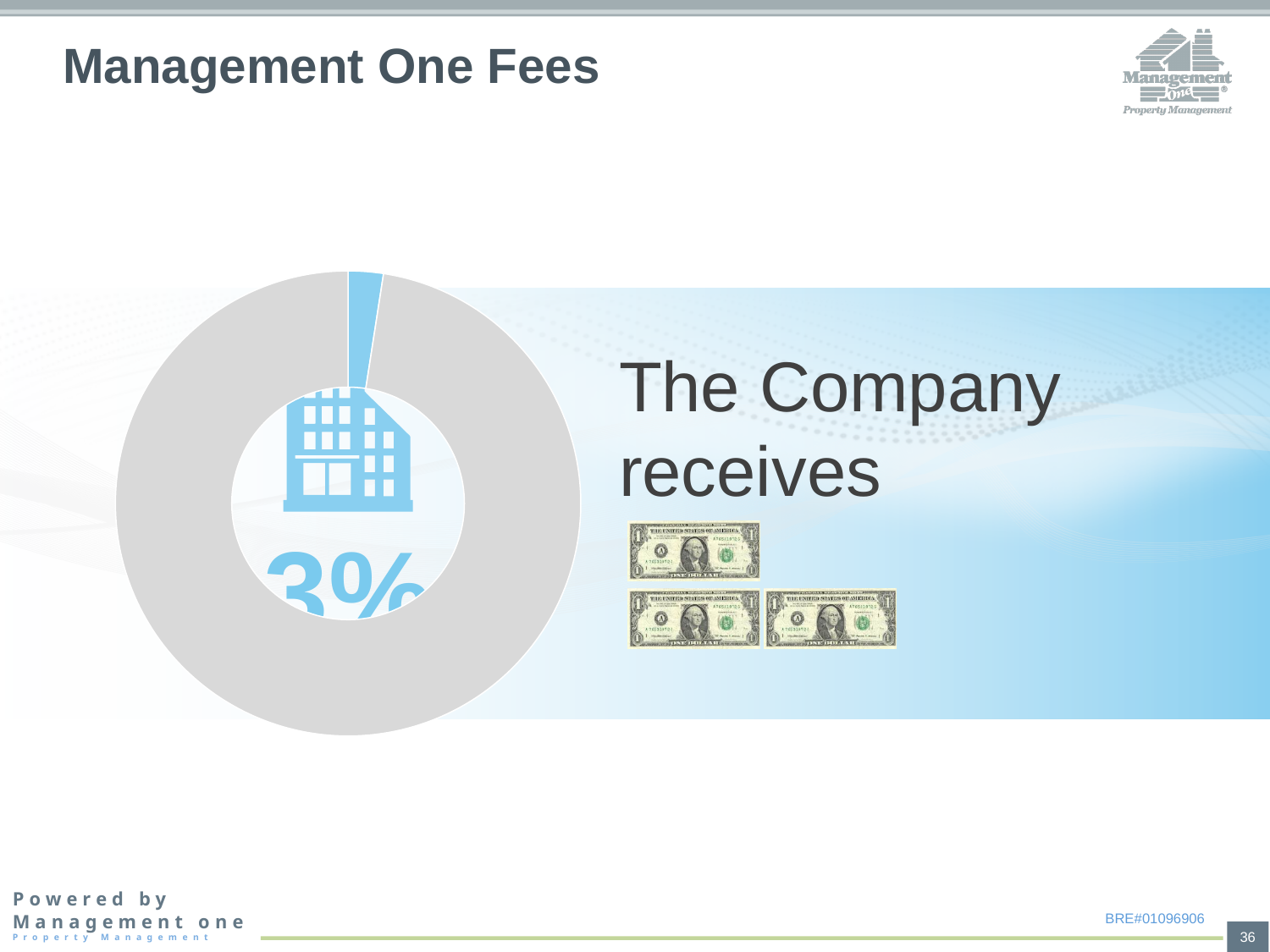
Which slice of the donut chart is larger, the blue slice or the grey slice? The grey slice How many slices does the donut chart have? 2 What kind of chart is shown on the slide? Pie chart (donut) Which slice of the donut chart is the smallest? The blue slice What share of the donut chart does the blue slice represent? 3% What is the title of the slide containing the donut chart? Management One Fees What colour is the slice labelled 3% in the donut chart? Blue